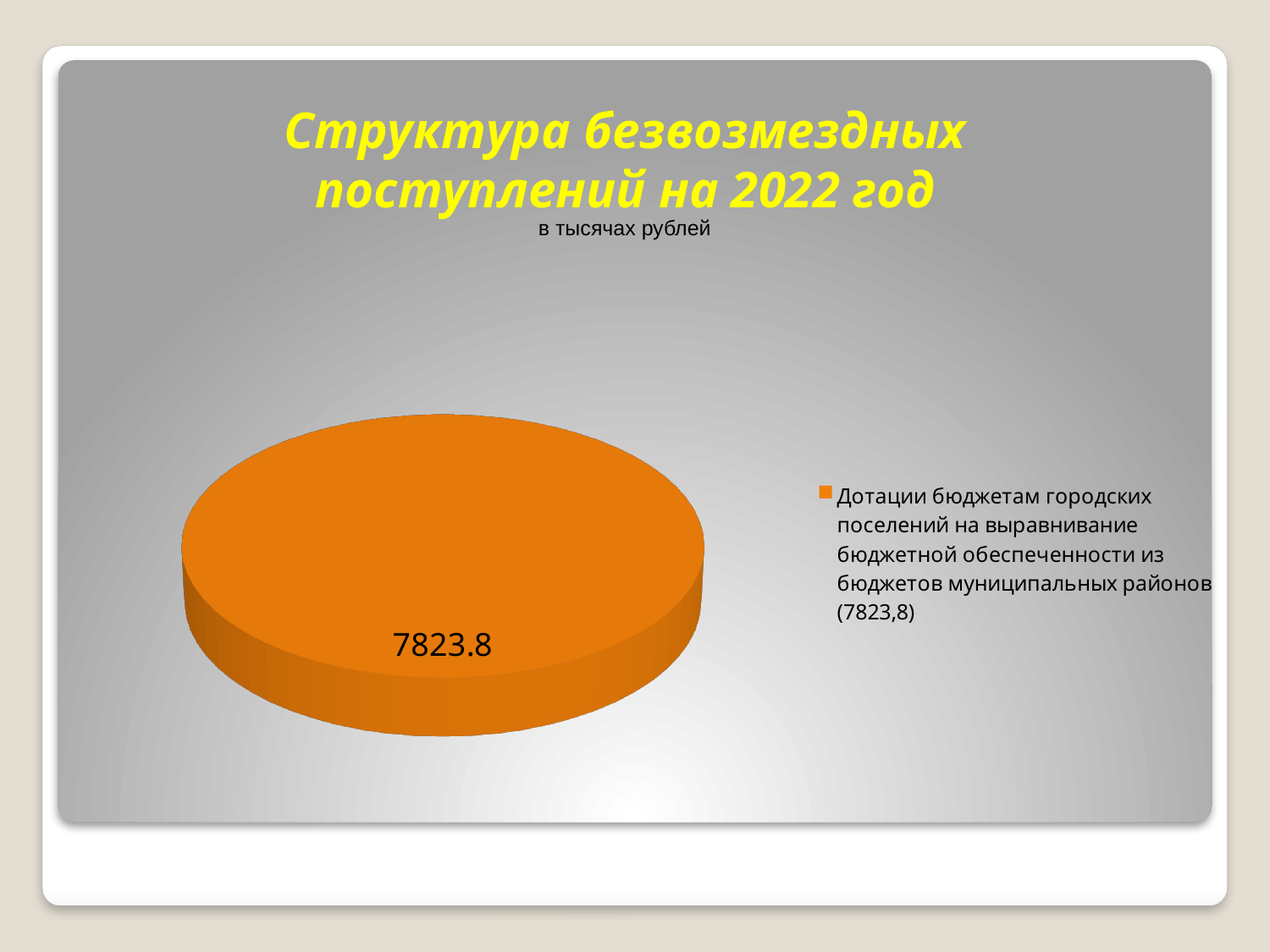
What value is printed on the pie chart slice? 7823.8 What is the title of the chart on the slide? Структура безвозмездных поступлений на 2022 год What is the value for 'Дотации бюджетам городских поселений на выравнивание бюджетной обеспеченности из бюджетов муниципальных районов' in the pie chart? 7823.8 What share of the pie does the slice 'Дотации бюджетам городских поселений на выравнивание бюджетной обеспеченности из бюджетов муниципальных районов' represent? 100% How many entries does the legend of the pie chart list? 1 What kind of chart is shown on the slide? Pie chart In what units are the values of the chart given, according to the subtitle? в тысячах рублей How many slices does the pie chart have? 1 Is the value shown on the pie chart slice greater or less than 7000? greater